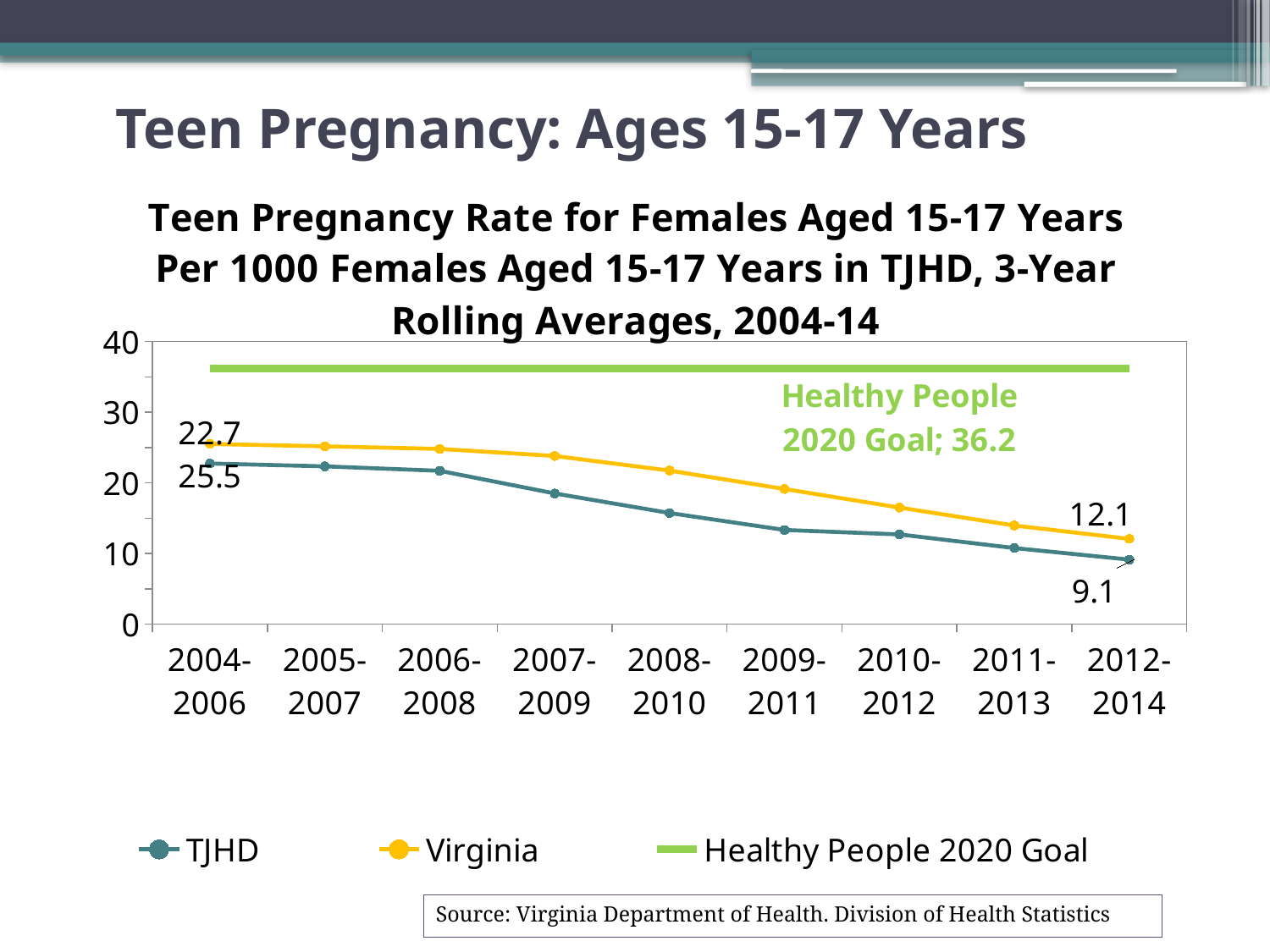
Is the Virginia value for 2008-2010 greater or less than 20? greater How many series does the legend list? 3 Which is higher in 2012-2014, the TJHD rate or the Virginia rate? Virginia Which series is drawn as a green horizontal line? Healthy People 2020 Goal Does the TJHD rate rise or fall from 2004-2006 to 2012-2014? fall What is the Healthy People 2020 Goal value shown on the chart? 36.2 What is the TJHD teen pregnancy rate for 2012-2014? 9.1 What type of chart is shown on the slide? line chart What is the Virginia teen pregnancy rate for 2012-2014? 12.1 Is the TJHD value for 2009-2011 greater or less than 20? less What is the difference between the Virginia and TJHD rates for 2012-2014? 3.0 How many time periods are shown on the x axis? 9